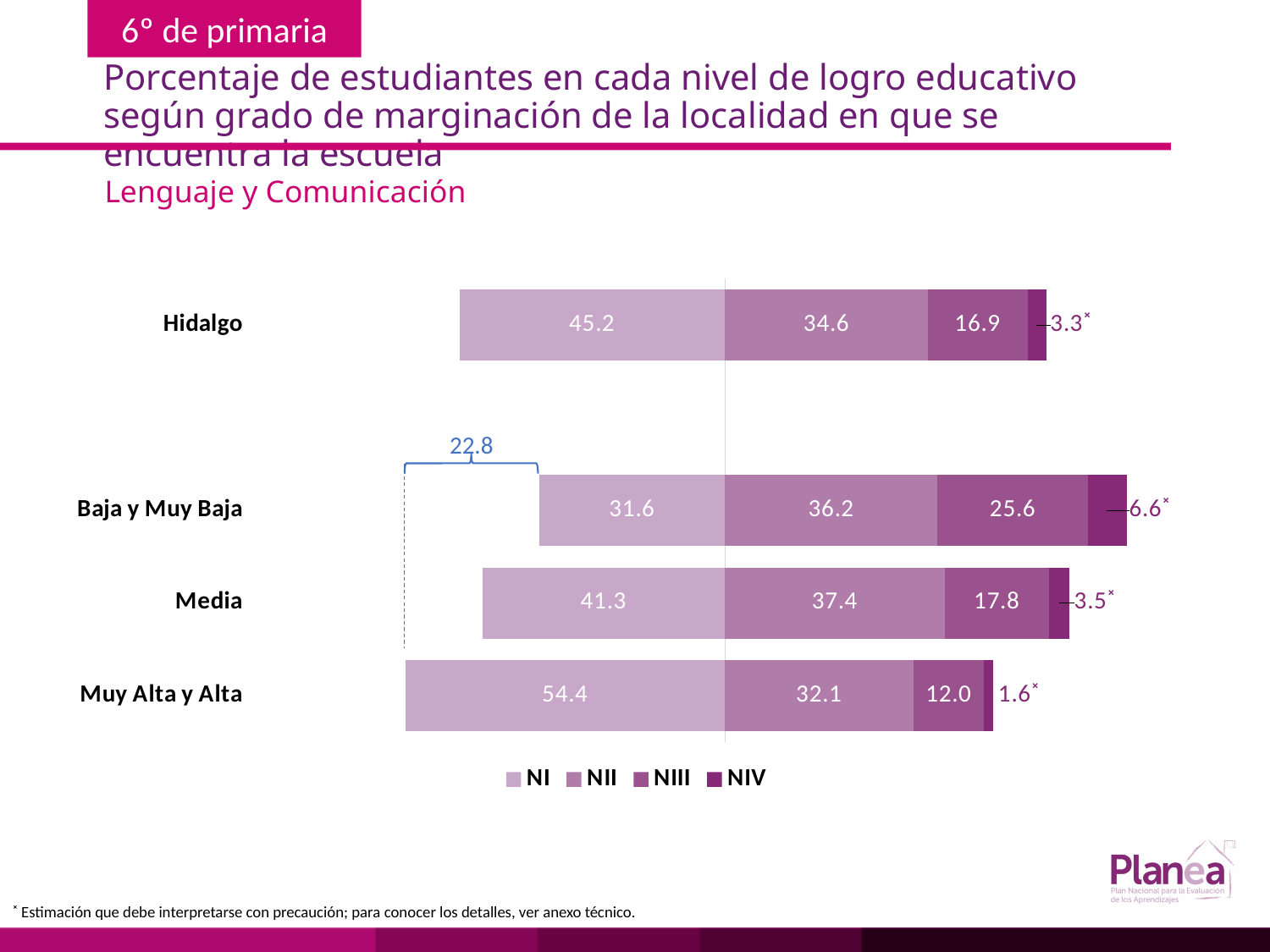
Which category has the lowest NIV value? Muy Alta y Alta What is the NIII value for Baja y Muy Baja? 25.6 What is the NIV value for Muy Alta y Alta? 1.6 How many series does the legend list? 4 What is the difference between the NI values for Muy Alta y Alta and Baja y Muy Baja? 22.8 What are the four legend entries of the chart? NI, NII, NIII, NIV How many categories (bars) are shown in the chart? 4 What type of chart is shown on the slide? Stacked bar chart What is the NI value for Hidalgo? 45.2 Which category has the highest NI value? Muy Alta y Alta Which is larger, the NIII value for Media or the NIII value for Hidalgo? Media What is the NII value for Media? 37.4